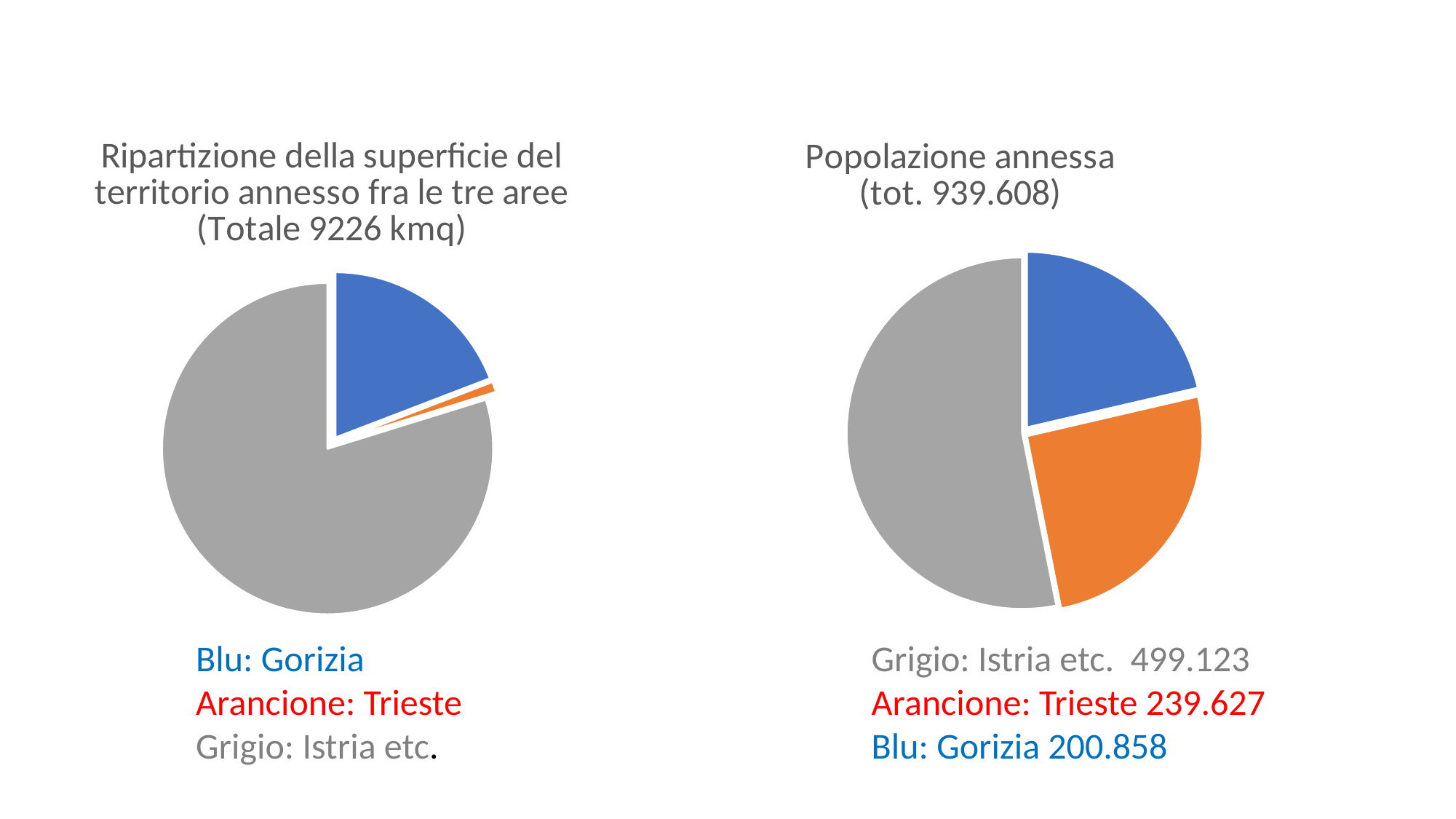
How many slices does the left chart, 'Ripartizione della superficie del territorio annesso', have? 3 What kind of chart is the left chart, 'Ripartizione della superficie del territorio annesso fra le tre aree'? pie chart In the left chart, 'Ripartizione della superficie del territorio annesso', which colour represents Gorizia? Blu In the right chart, 'Popolazione annessa', what is the total annexed population? 939.608 In the left chart, 'Ripartizione della superficie del territorio annesso', which area has the largest share of the territory? Istria etc. In the left chart, 'Ripartizione della superficie del territorio annesso', which area has the smallest share of the territory? Trieste In the right chart, 'Popolazione annessa', which area has the largest population? Istria etc. In the right chart, 'Popolazione annessa', what is the population for Istria etc.? 499.123 In the right chart, 'Popolazione annessa', what is the population for Gorizia? 200.858 In the left chart, 'Ripartizione della superficie del territorio annesso', what total area is stated in the title? 9226 kmq In the right chart, 'Popolazione annessa', what is the population for Trieste? 239.627 In the right chart, 'Popolazione annessa', what is the difference between the population of Trieste and that of Gorizia? 38.769